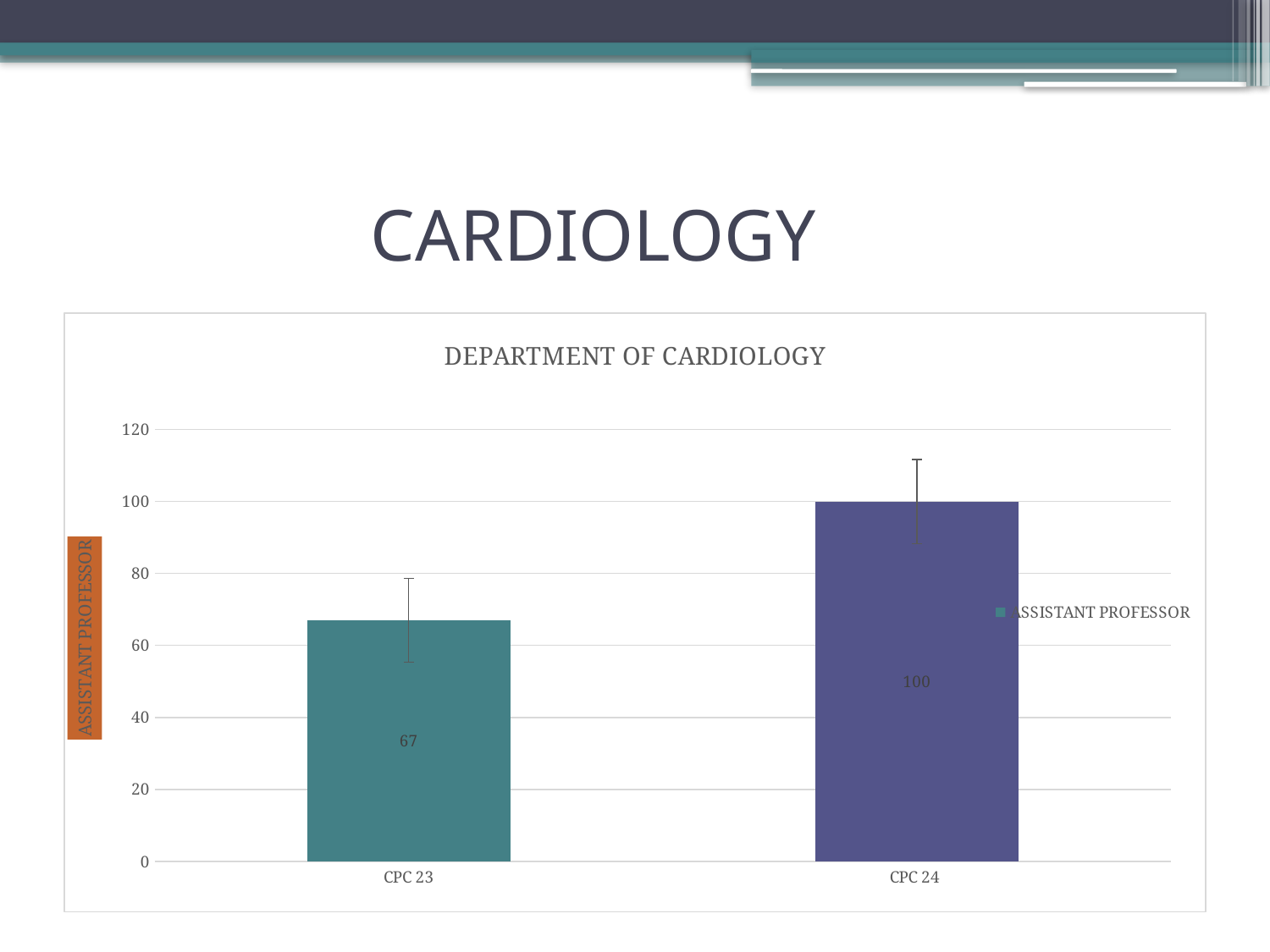
What kind of chart is shown? bar chart What is the value for CPC 23? 67 What is the title of the chart? DEPARTMENT OF CARDIOLOGY Is the value for CPC 23 greater or less than 80? less How many categories are shown on the x axis? 2 How many series does the legend list? 1 Which is larger, the value for CPC 23 or the value for CPC 24? CPC 24 Which category has the lowest value? CPC 23 What is the difference between the values for CPC 24 and CPC 23? 33 What is the value for CPC 24? 100 Which category has the highest value? CPC 24 Do the values rise or fall from CPC 23 to CPC 24? rise